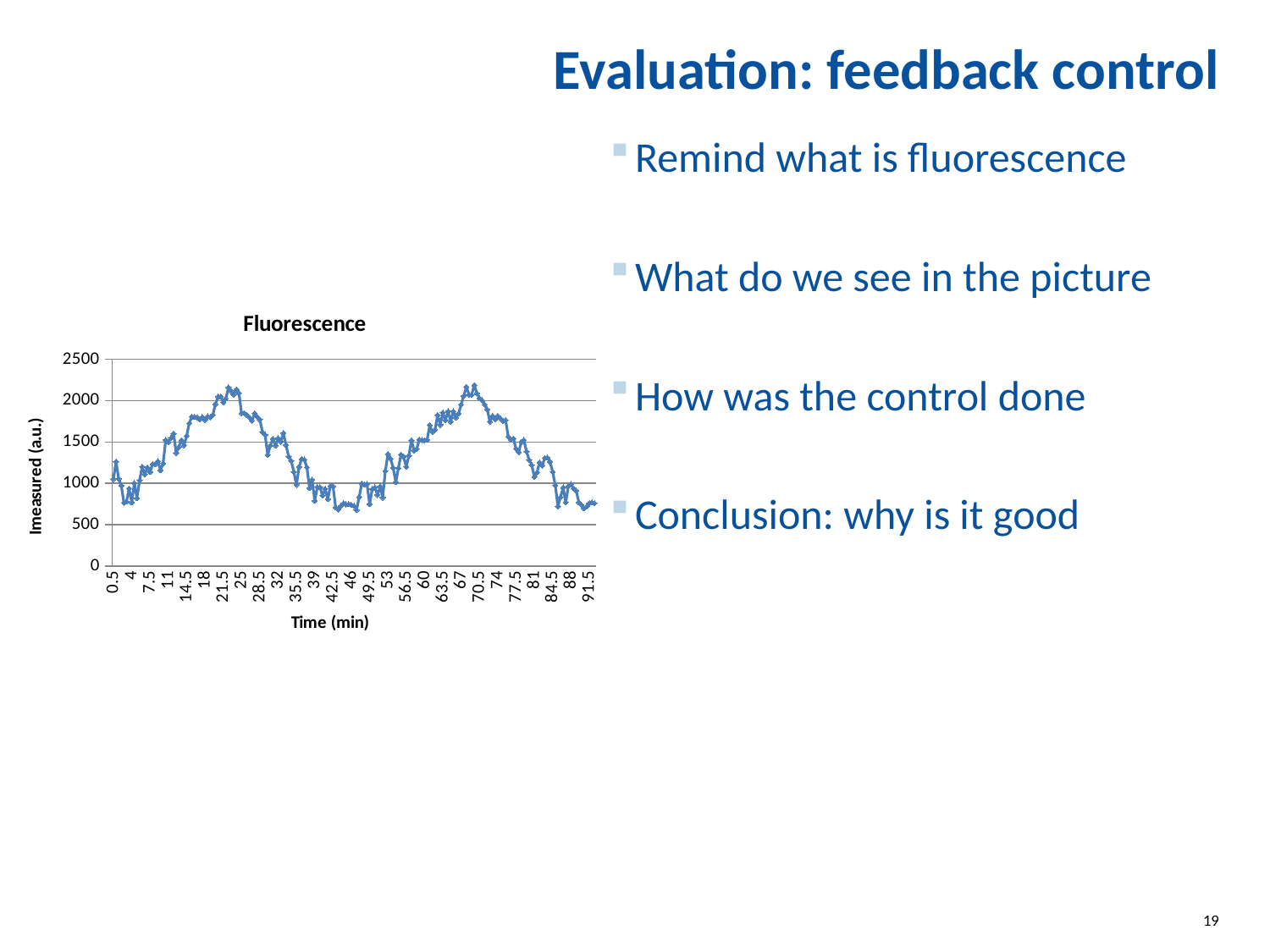
How many data series are plotted in the chart? 1 Does the fluorescence value rise or fall between 25 min and 42.5 min? fall How many major peaks does the fluorescence curve show over the plotted time range? 2 What is the label of the x axis of the chart? Time (min) Is the fluorescence value at 67 min greater or less than 1500? greater What is the title of the chart? Fluorescence What kind of chart is shown on the slide? line chart Is the fluorescence value at 21.5 min larger or smaller than the value at 42.5 min? larger Is the fluorescence value at 21.5 min greater or less than 1500? greater Does the fluorescence value rise or fall between 7.5 min and 21.5 min? rise